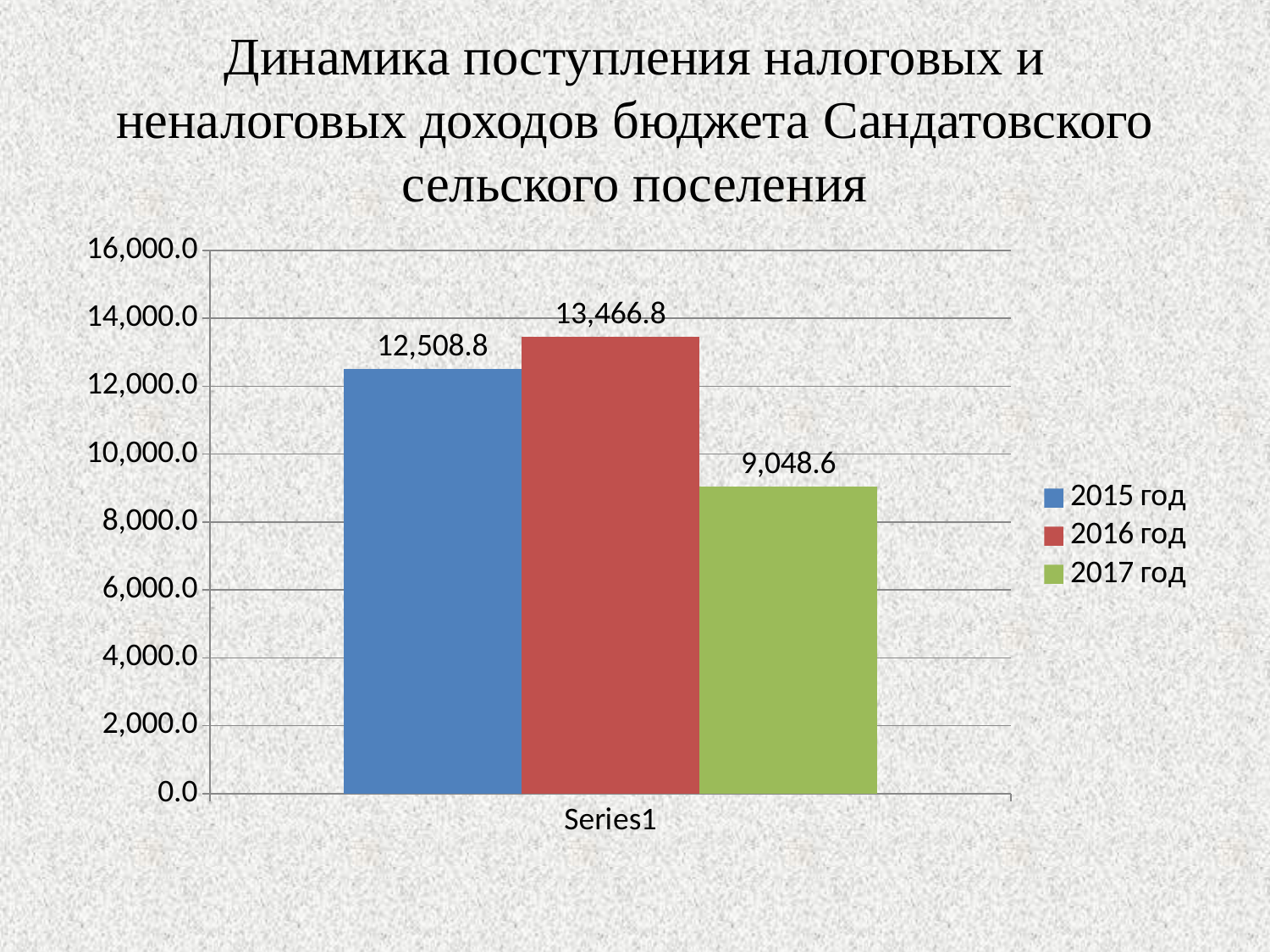
Which is larger, the value for 2015 год or the value for 2017 год? 2015 год What kind of chart is shown on the slide? bar chart Which year has the lowest value? 2017 год What is the value for 2016 год? 13,466.8 What is the value for 2015 год? 12,508.8 Is the value for 2017 год greater or less than 10,000.0? less What is the difference between the values for 2015 год and 2017 год? 3,460.2 Which year has the highest value? 2016 год What is the value for 2017 год? 9,048.6 What colour is the bar for 2016 год? red What is the difference between the values for 2016 год and 2015 год? 958.0 How many series does the legend list? 3